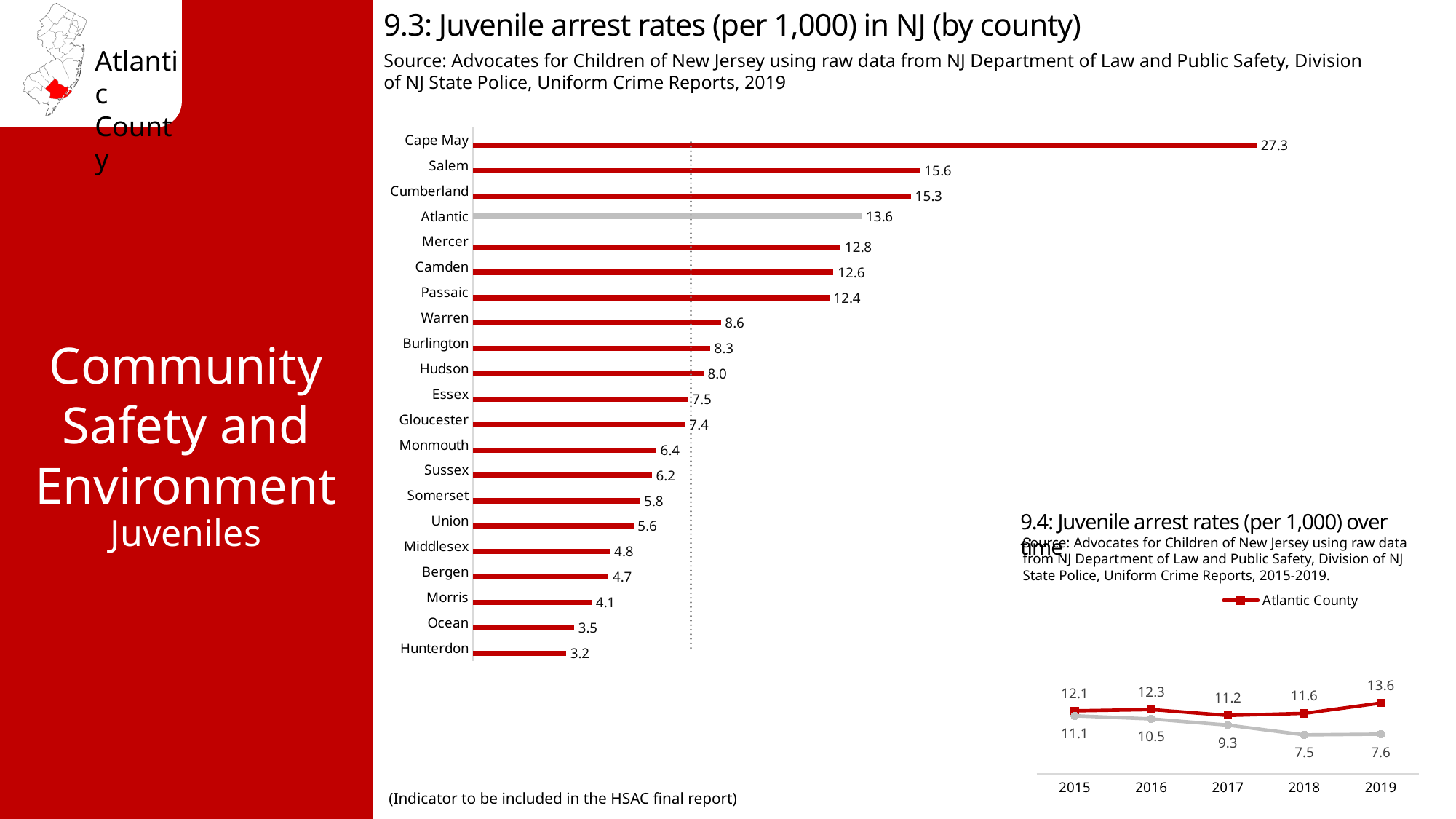
In chart 9.3 (juvenile arrest rates by county), what is the difference between the rates for Cape May and Salem? 11.7 In chart 9.4 (juvenile arrest rates over time), what was the Atlantic County juvenile arrest rate in 2017? 11.2 In chart 9.3 (juvenile arrest rates by county), what is the value for Passaic? 12.4 In chart 9.3 (juvenile arrest rates by county), which bar is shown in gray rather than red? Atlantic In chart 9.3 (juvenile arrest rates by county), which county has the highest juvenile arrest rate? Cape May In chart 9.4 (juvenile arrest rates over time), how many years are shown on the x axis? 5 What type of chart is chart 9.3 (juvenile arrest rates by county)? Bar chart In chart 9.3 (juvenile arrest rates by county), how many counties are shown? 21 In chart 9.3 (juvenile arrest rates by county), what is the juvenile arrest rate for Atlantic County? 13.6 In chart 9.4 (juvenile arrest rates over time), in which year was the Atlantic County juvenile arrest rate highest? 2019 In chart 9.3 (juvenile arrest rates by county), which county has the lowest juvenile arrest rate? Hunterdon In chart 9.3 (juvenile arrest rates by county), which has a higher juvenile arrest rate, Mercer or Camden? Mercer